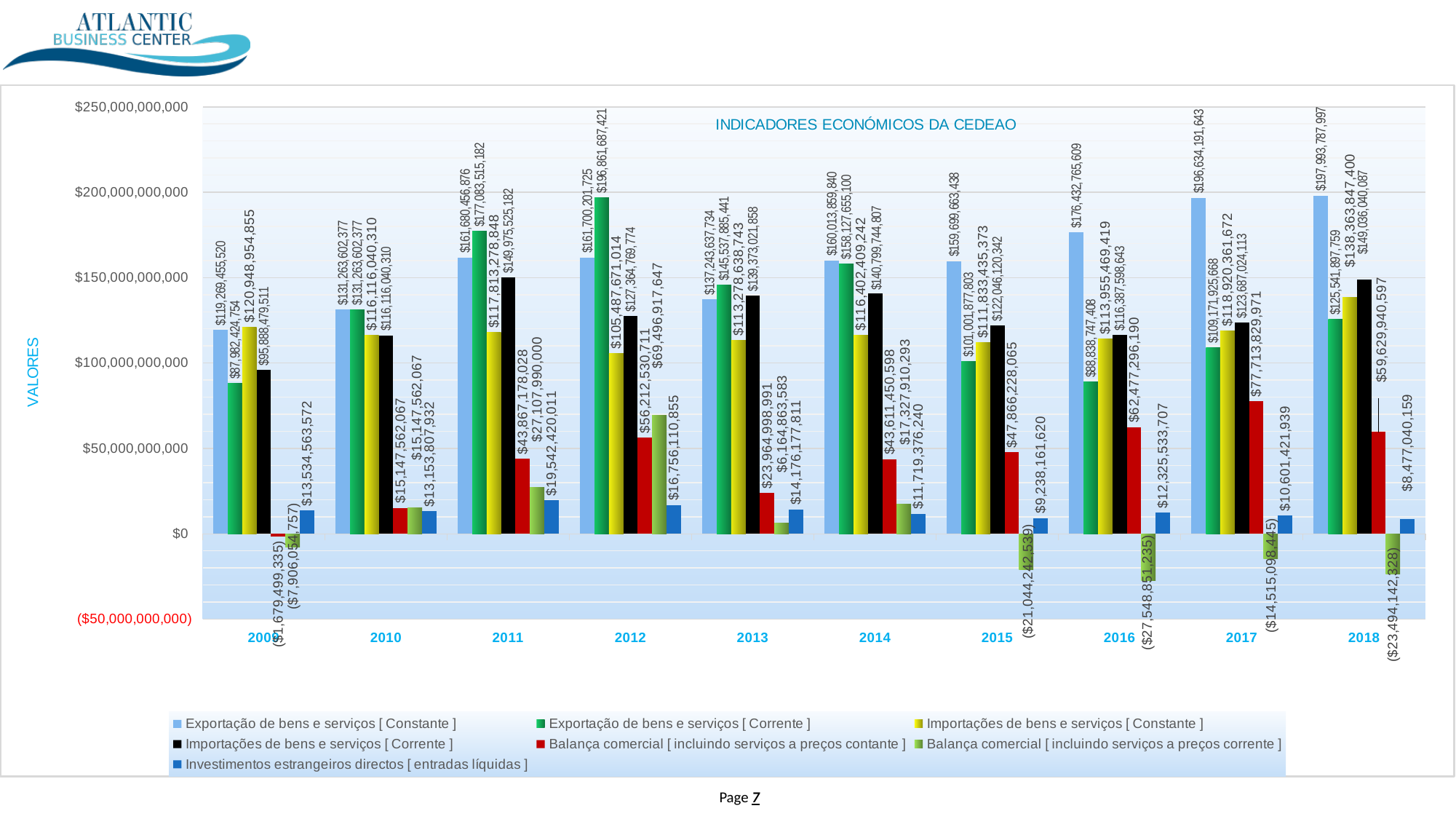
In which year is Investimentos estrangeiros directos [ entradas líquidas ] lowest? 2018 What is the value of Investimentos estrangeiros directos [ entradas líquidas ] for 2009? $13,534,563,572 How many series does the legend list? 7 What kind of chart is shown? bar chart Does Exportação de bens e serviços [ Constante ] rise or fall from 2015 to 2018? rise In 2011, which is larger: Exportação de bens e serviços [ Corrente ] or Importações de bens e serviços [ Corrente ]? Exportação de bens e serviços [ Corrente ] What is the value of Exportação de bens e serviços [ Constante ] for 2018? $197,993,787,997 In which year is Exportação de bens e serviços [ Corrente ] highest? 2012 What is the difference between Exportação de bens e serviços [ Constante ] and Exportação de bens e serviços [ Corrente ] in 2018? $72,451,890,238 What is the value of Balança comercial [ incluindo serviços a preços corrente ] for 2016? ($27,548,851,235) Is the value of Exportação de bens e serviços [ Constante ] for 2016 greater or less than $150,000,000,000? greater How many years are shown on the x axis? 10